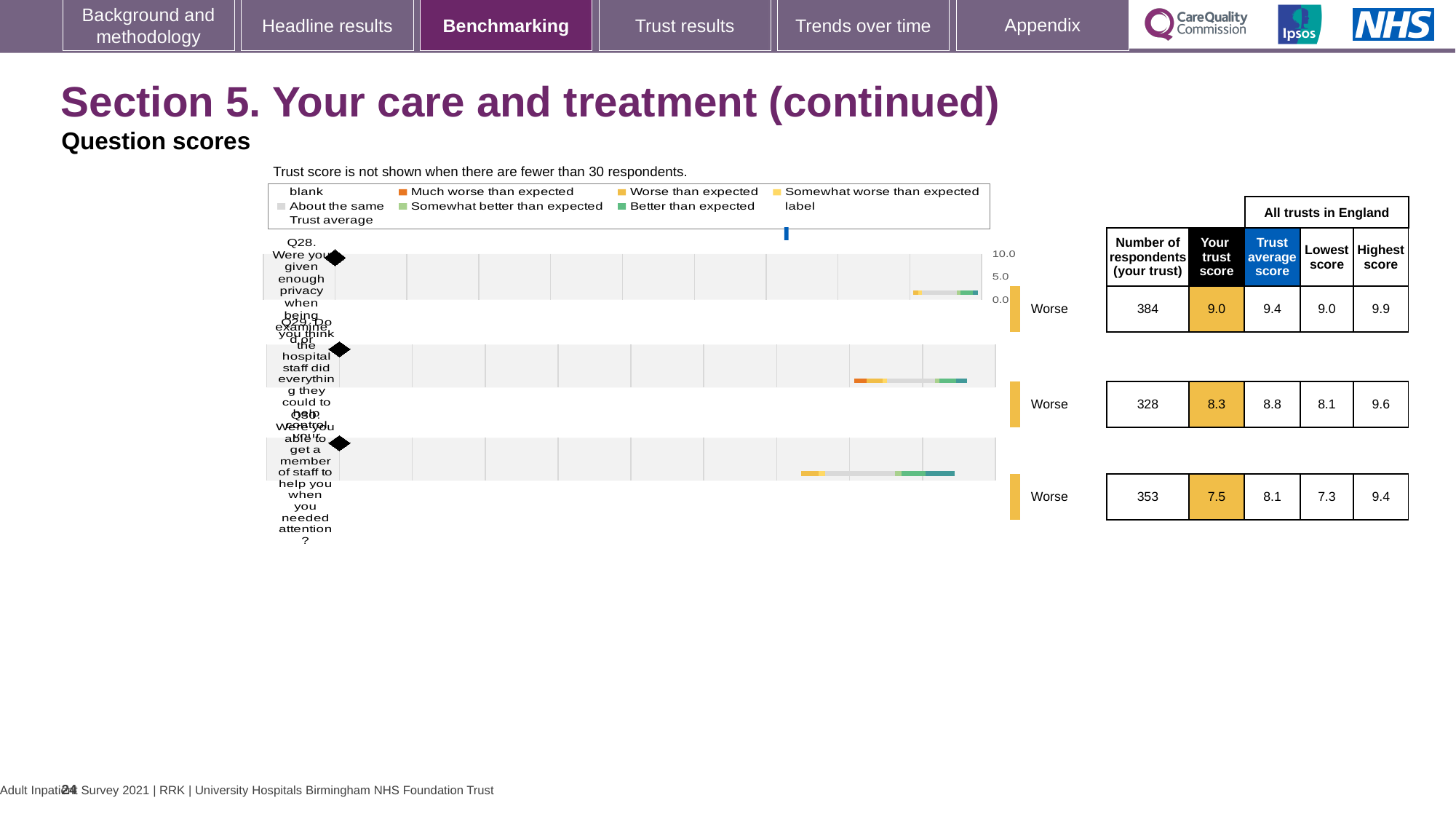
Is the 'Your trust score' for Q30 greater or less than 5.0? greater How many questions are plotted on the slide? 3 What kind of chart is used to show the question scores? Bar chart What is the 'Your trust score' value for Q28? 9.0 How many respondents are shown for Q30? 353 What benchmark category label is shown next to the chart for Q28? Worse What is the difference between the trust average score and 'Your trust score' for Q30? 0.6 What is the lowest score across all trusts in England for Q30? 7.3 Which is larger: the 'Your trust score' for Q28 or for Q29? Q28 What is the trust average score for Q29? 8.8 Which question (Q28, Q29 or Q30) has the lowest 'Your trust score'? Q30 What is the highest score across all trusts in England for Q29? 9.6